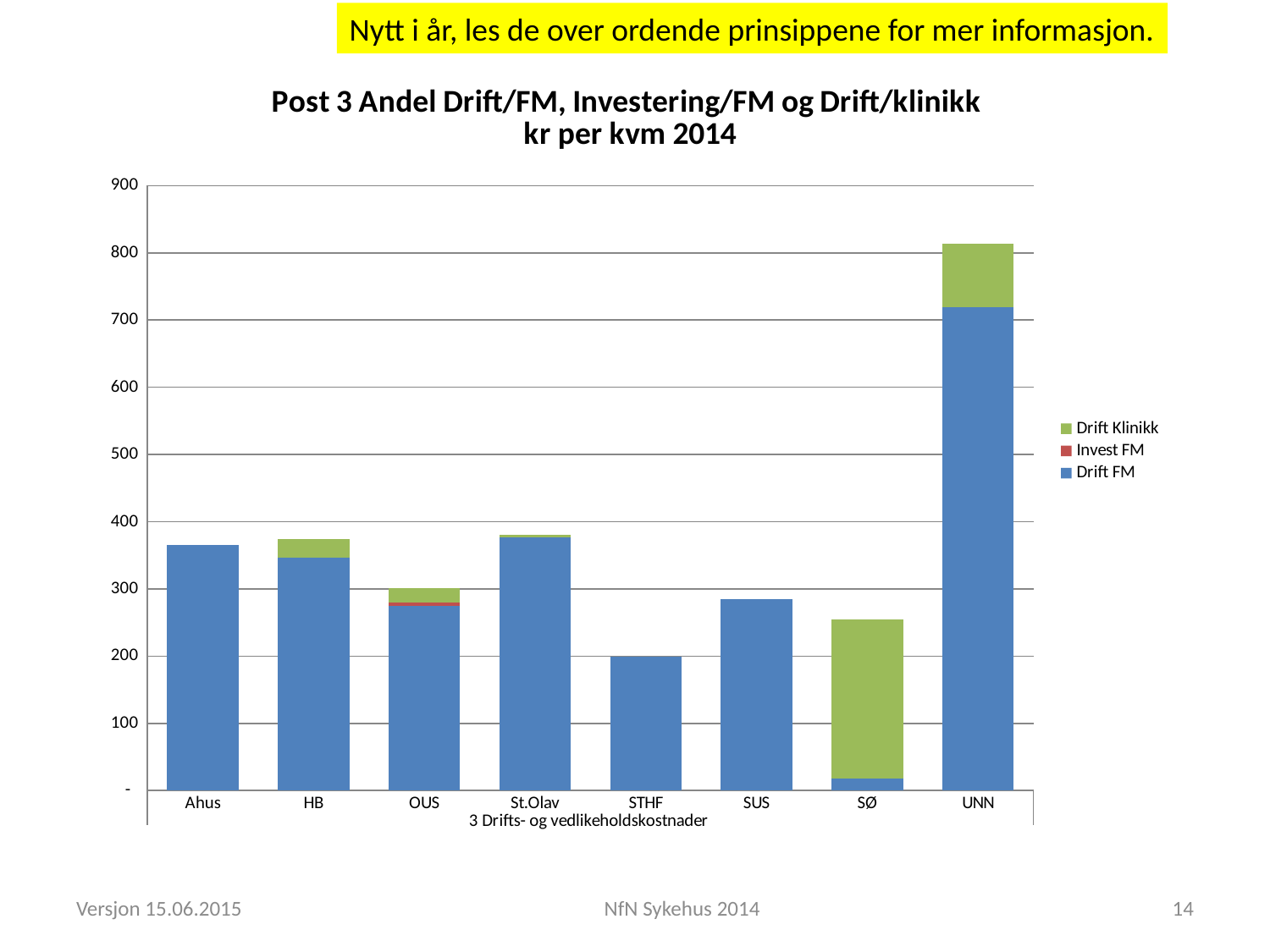
Is the total value for UNN greater or less than 700? greater Which category has the largest Drift Klinikk segment? SØ Which category has the lowest total bar? STHF Which category has the smallest Drift FM segment? SØ Is the total value for HB greater or less than 400? less What is the title of the chart? Post 3 Andel Drift/FM, Investering/FM og Drift/klinikk kr per kvm 2014 Which has a larger total bar, Ahus or SUS? Ahus What kind of chart is shown on the slide? Stacked bar chart Which category has the highest total bar? UNN Is the value for SUS greater or less than 300? less How many categories (hospitals) are shown on the x axis? 8 How many series does the legend list? 3